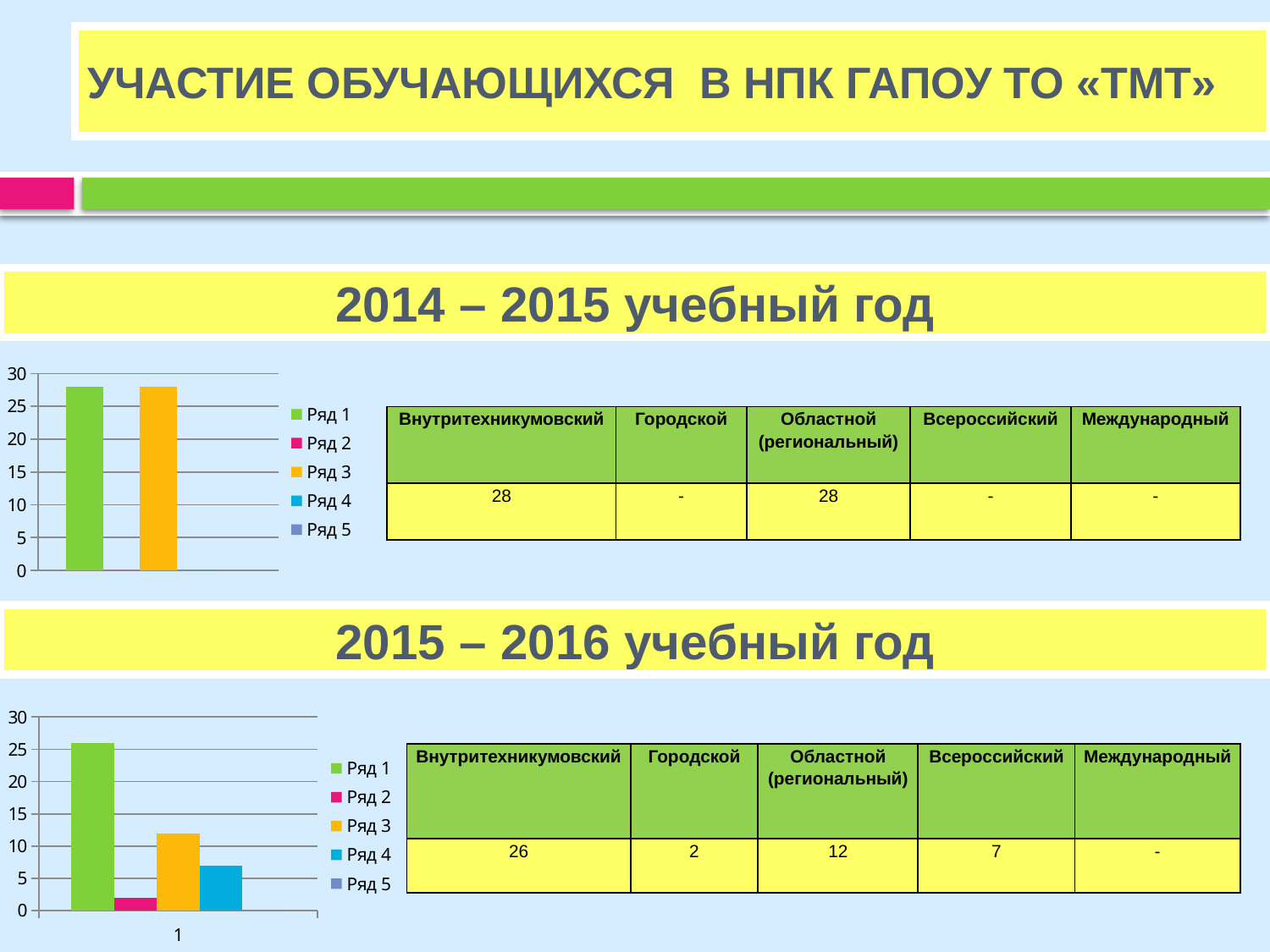
In the chart under "2014 – 2015 учебный год", what colour is the bar for Ряд 3? orange In the chart under "2015 – 2016 учебный год", which series has the highest bar? Ряд 1 In the chart under "2015 – 2016 учебный год", is the value for Ряд 4 greater or less than 10? less In the chart under "2015 – 2016 учебный год", is the value for Ряд 2 greater or less than 5? less In the chart under "2015 – 2016 учебный год", which of the visible bars is the lowest? Ряд 2 In the chart under "2014 – 2015 учебный год", is the value for Ряд 1 greater or less than 25? greater How many bars are visible in the chart under "2014 – 2015 учебный год"? 2 What kind of chart is the chart under the heading "2014 – 2015 учебный год"? bar chart In the chart under "2015 – 2016 учебный год", which is larger, Ряд 3 or Ряд 4? Ряд 3 How many series does the legend of the chart under "2014 – 2015 учебный год" list? 5 How many bars are visible in the chart under "2015 – 2016 учебный год"? 4